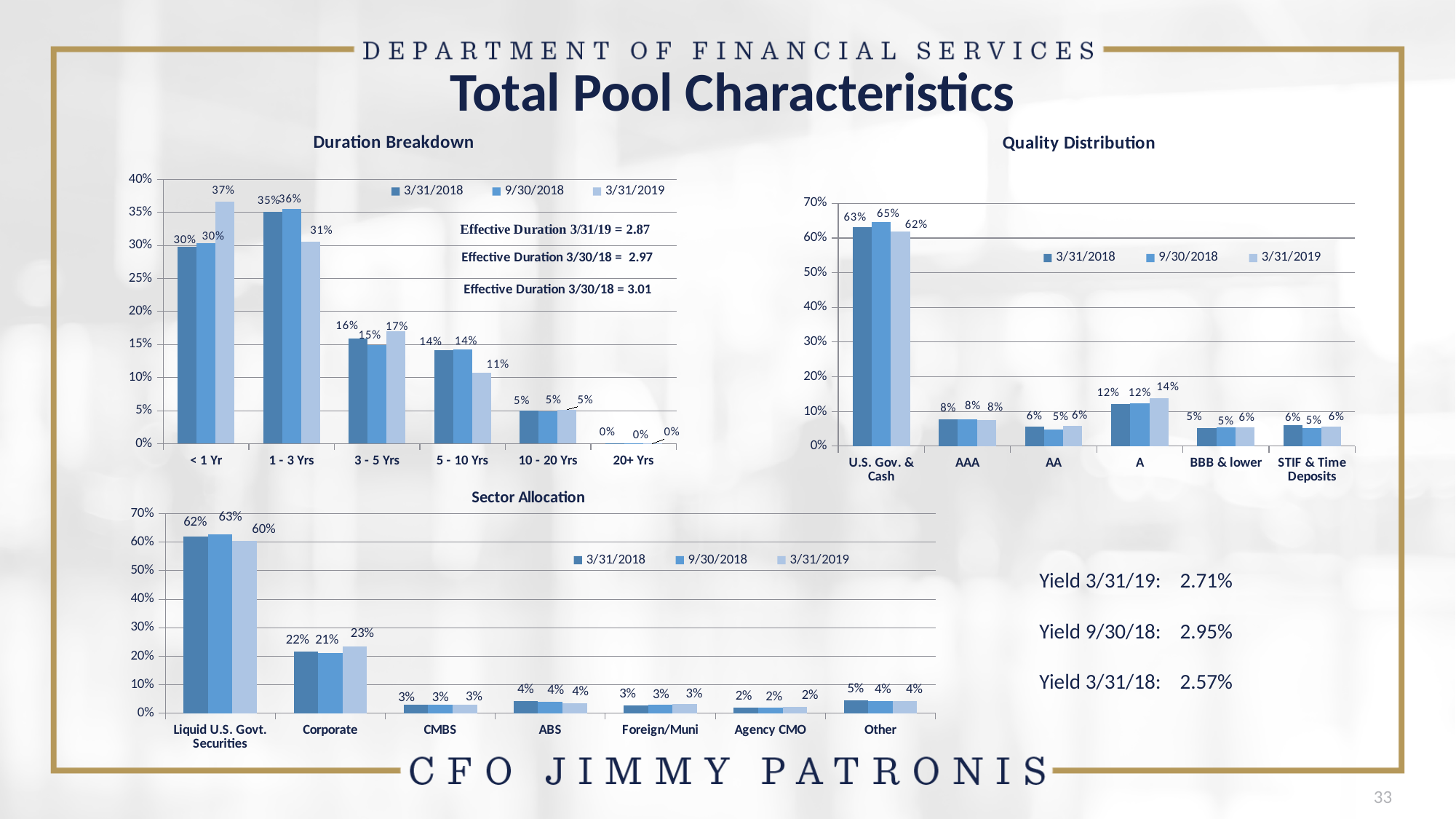
In the Duration Breakdown chart, how many duration categories are shown on the x axis? 6 In the Quality Distribution chart, which category has the lowest value in the 9/30/2018 series? AA, BBB & lower and STIF & Time Deposits (all 5%) In the Sector Allocation chart, how many sector categories are shown on the x axis? 7 In the Duration Breakdown chart, what is the value for < 1 Yr in the 3/31/2019 series? 37% How many series does the legend of the Quality Distribution chart list? 3 In the Duration Breakdown chart, which category has the highest value in the 3/31/2018 series? 1 - 3 Yrs In the Quality Distribution chart, what is the value for U.S. Gov. & Cash in the 9/30/2018 series? 65% In the Sector Allocation chart, which is larger for Liquid U.S. Govt. Securities: the 9/30/2018 value or the 3/31/2019 value? 9/30/2018 In the Sector Allocation chart, what is the value for Corporate in the 3/31/2019 series? 23% What kind of chart is the Sector Allocation chart? Bar chart In the Quality Distribution chart, what is the difference between the 3/31/2019 value for A and the 3/31/2018 value for A? 2% In the Duration Breakdown chart, what is the value for 5 - 10 Yrs in the 3/31/2019 series? 11%